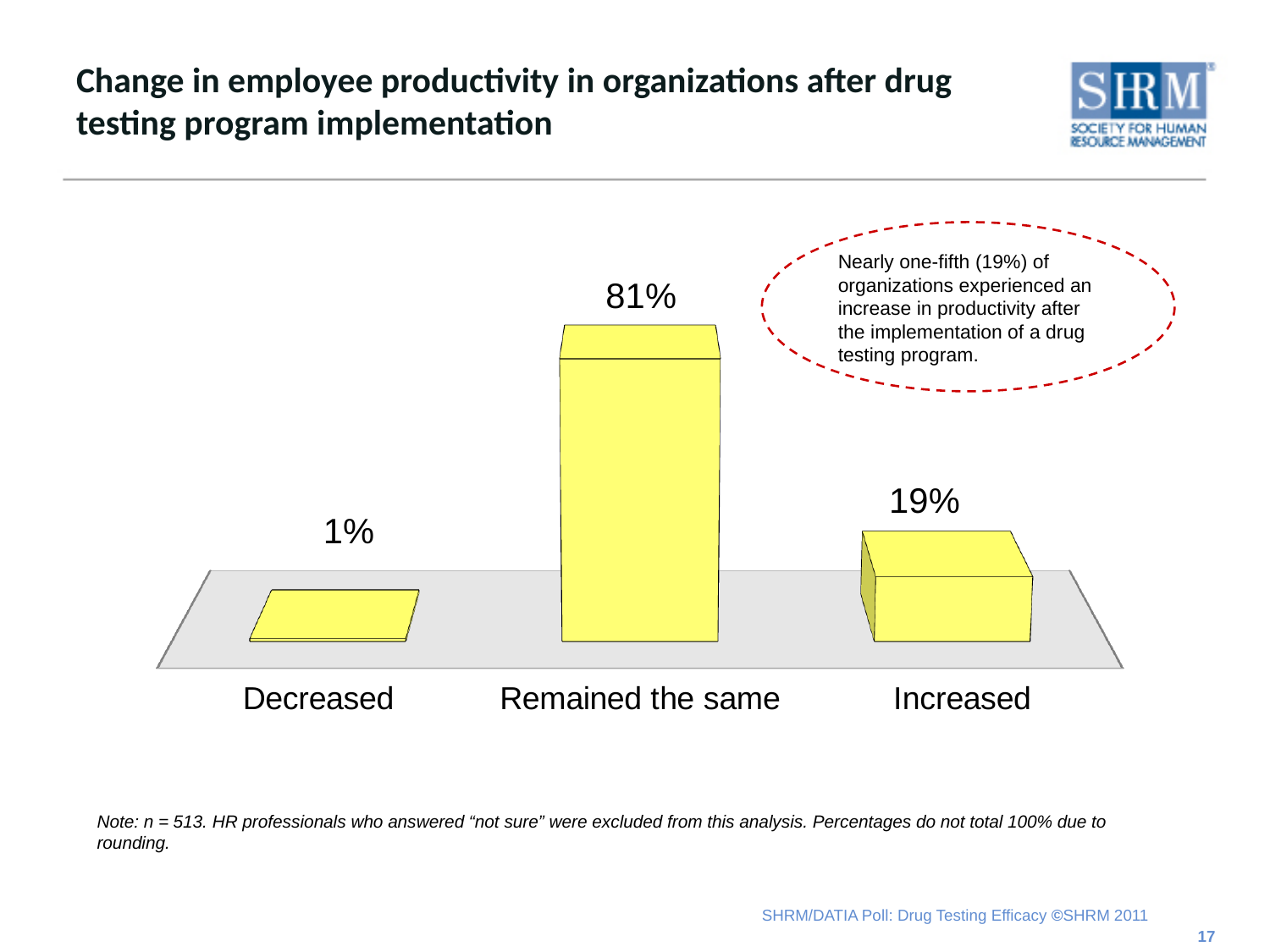
What is the difference between the 'Increased' and 'Decreased' values? 18% What percentage of organizations reported that employee productivity decreased? 1% What is the sample size (n) given in the note below the chart? 513 What percentage of organizations reported that employee productivity increased? 19% What percentage of organizations reported that employee productivity remained the same after drug testing program implementation? 81% What is the difference between the 'Remained the same' and 'Increased' values? 62% Which category has the highest value? Remained the same What kind of chart is shown on the slide? Bar chart What colour are the bars in the chart? Yellow Which category has the lowest value? Decreased Which is larger, the value for 'Increased' or the value for 'Decreased'? Increased How many categories are shown in the chart? 3